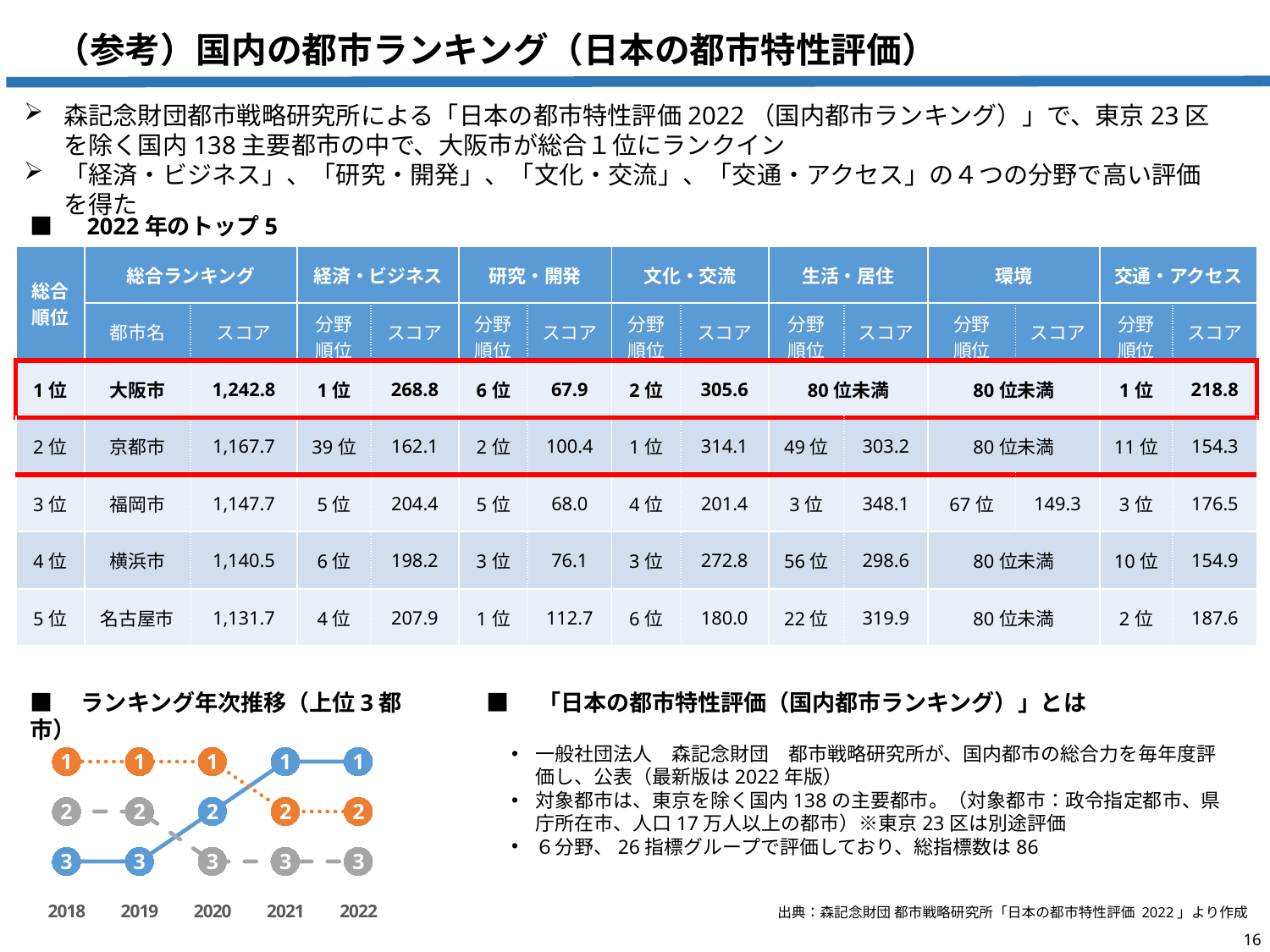
In the ランキング年次推移 chart, in which year does the blue line first reach rank 1? 2021 In the ランキング年次推移 chart, what rank does the gray line show in 2020? 3 In the ランキング年次推移 chart, what is the first year shown on the x axis? 2018 In the ランキング年次推移 chart, how many years are shown on the x axis? 5 In the ランキング年次推移 chart, what rank does the blue line show in 2022? 1 In the ランキング年次推移 chart, what rank does the blue line show in 2018? 3 In the ランキング年次推移 chart, how many lines (cities) are plotted? 3 What is the title of the line chart at the bottom left of the slide? ランキング年次推移（上位3都市） What kind of chart is shown at the bottom left of the slide (ランキング年次推移)? line chart In the ランキング年次推移 chart, what rank does the orange line show in 2018? 1 In the ランキング年次推移 chart, does the rank number on the blue line go up or down from 2018 to 2022? down In the ランキング年次推移 chart, what rank does the orange line show in 2021? 2